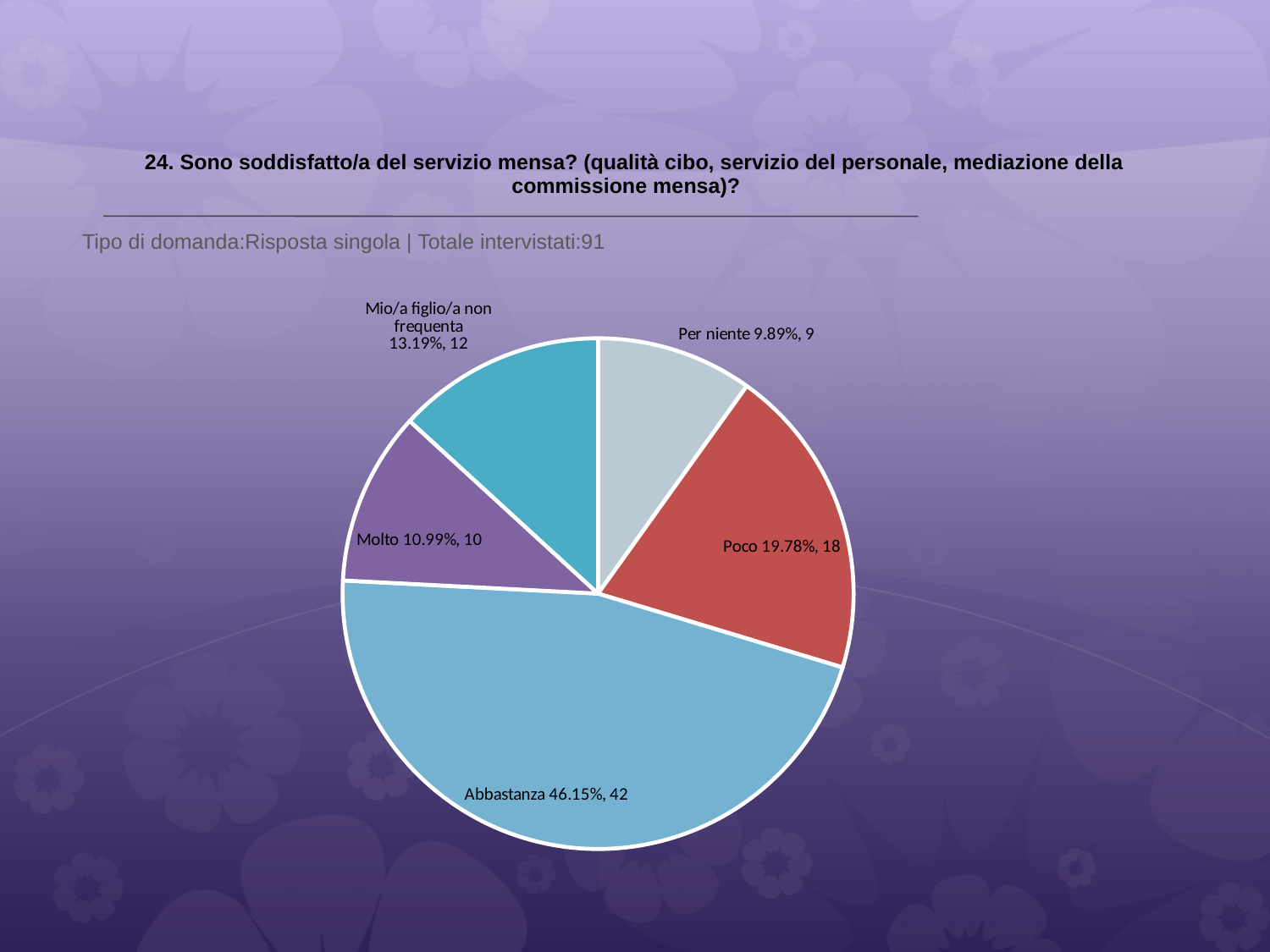
What percentage of respondents answered "Per niente"? 9.89% Which response has the smallest share of the pie? Per niente What is the total number of respondents (Totale intervistati) stated on the slide? 91 How many respondents answered "Poco"? 18 Which has more respondents, "Molto" or "Mio/a figlio/a non frequenta"? Mio/a figlio/a non frequenta How many more respondents answered "Abbastanza" than "Poco"? 24 How many respondents answered "Mio/a figlio/a non frequenta"? 12 Which response has the largest share of the pie? Abbastanza What kind of chart is shown on the slide? pie chart What percentage of respondents answered "Abbastanza"? 46.15% What is the share of the pie for "Molto"? 10.99% How many slices does the pie chart have? 5